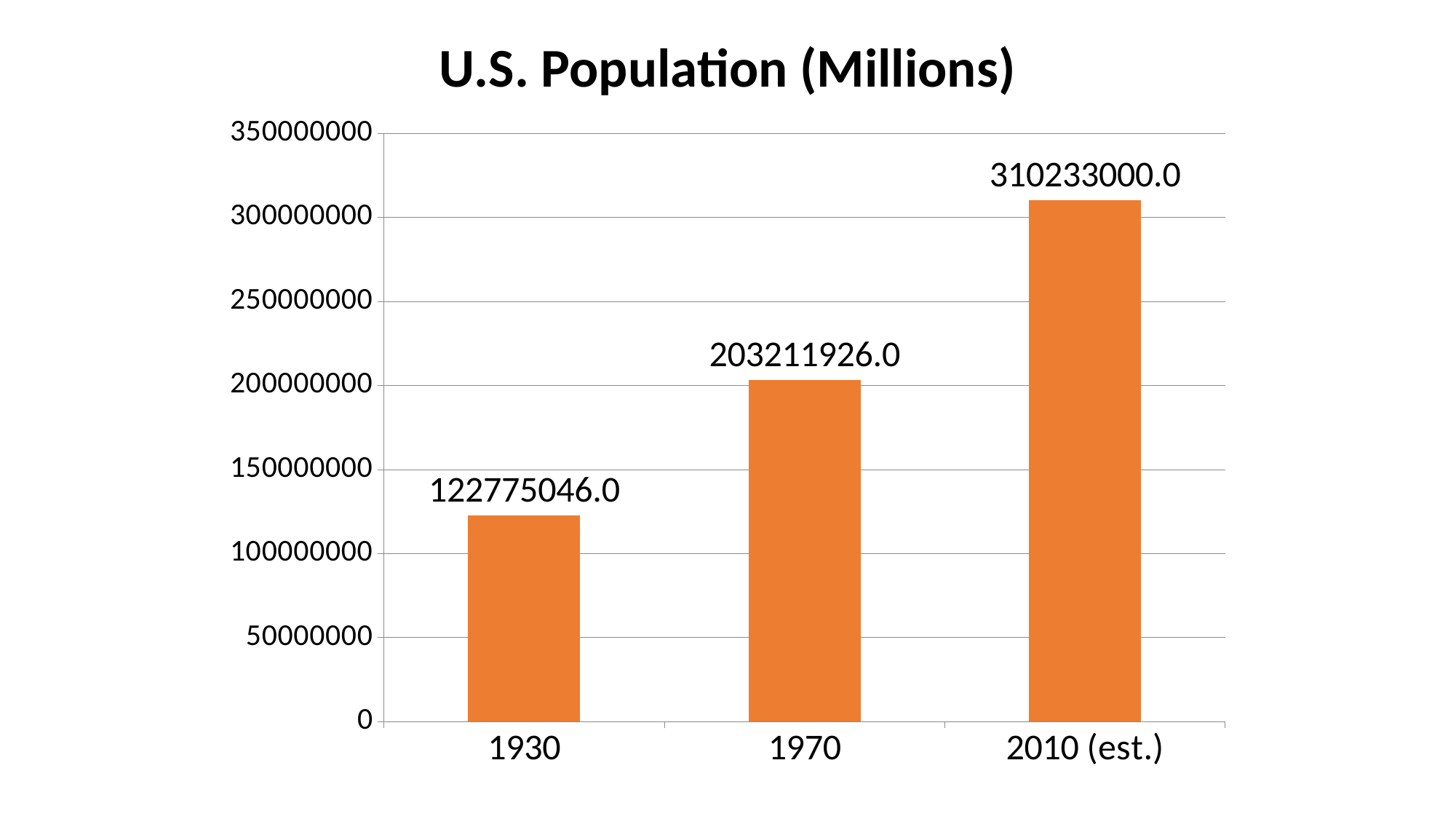
What is the value for 1970? 203211926.0 What is the value for 1930? 122775046.0 Which is larger, the value for 1930 or the value for 1970? 1970 What kind of chart is shown on the slide? bar chart Which category has the lowest value? 1930 What is the value for 2010 (est.)? 310233000.0 What is the difference between the values for 1970 and 1930? 80436880.0 Is the value for 2010 (est.) greater or less than 300000000? greater Do the values rise or fall from 1930 to 2010 (est.)? rise What is the difference between the values for 2010 (est.) and 1970? 107021074.0 How many categories are shown on the x axis? 3 Which category has the highest value? 2010 (est.)